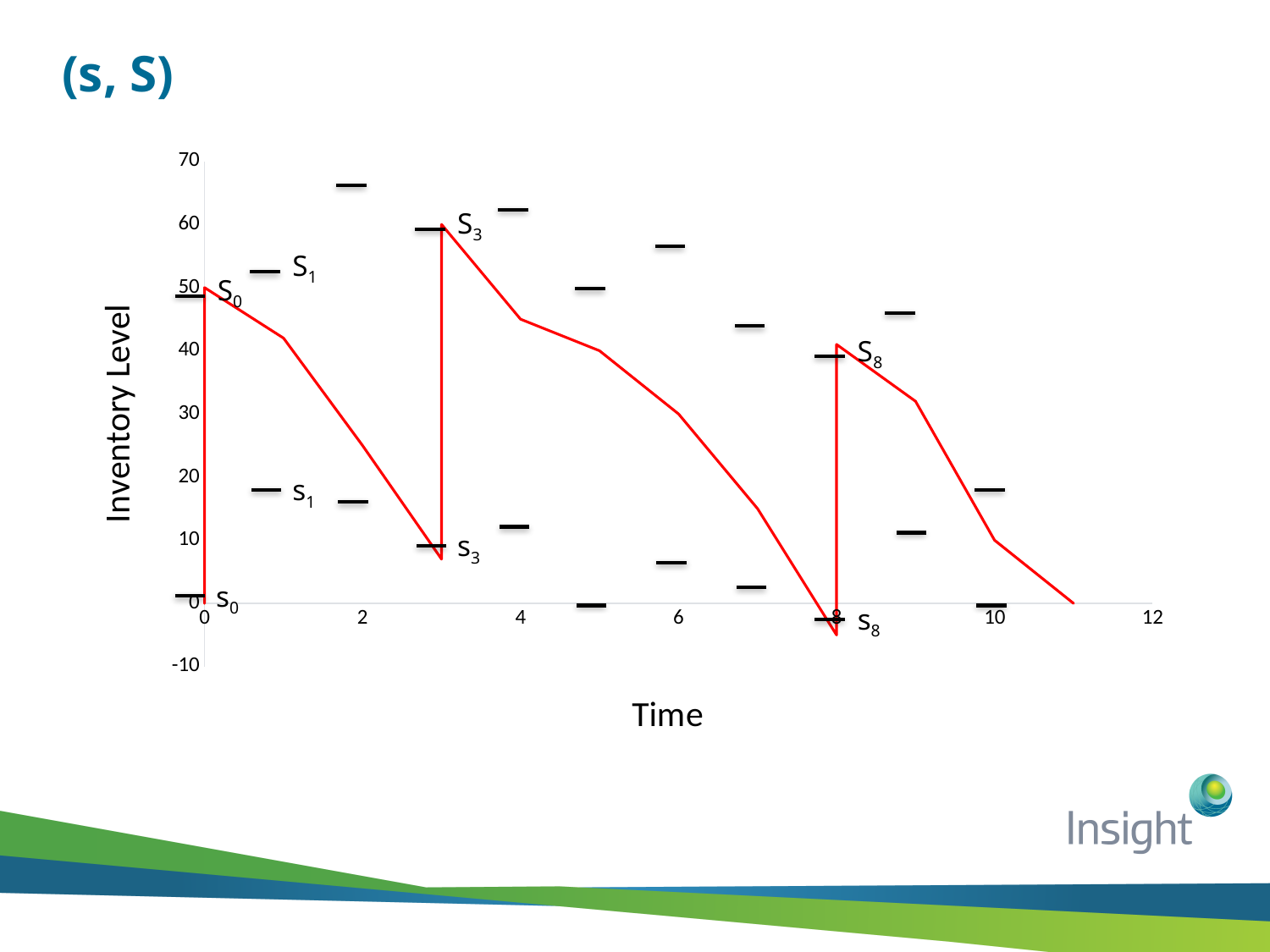
What is the label of the vertical axis? Inventory Level Is the inventory level at the S0 point (time 0) greater or less than 40? greater Is the inventory level at the S3 point (time 3) greater or less than 50? greater What kind of chart is shown on the slide? line chart Which is higher on the chart, the lower s1 marker or the lower s3 marker? s1 Is the inventory level at the S8 point (time 8) greater or less than 30? greater How many times does the red inventory line jump vertically upward (reorders) on the chart? 3 Between time 3 and time 8, does the red inventory line rise or fall? fall Which is higher on the chart, the S0 level or the S3 level? S3 What is the title of the chart on the slide? (s, S)